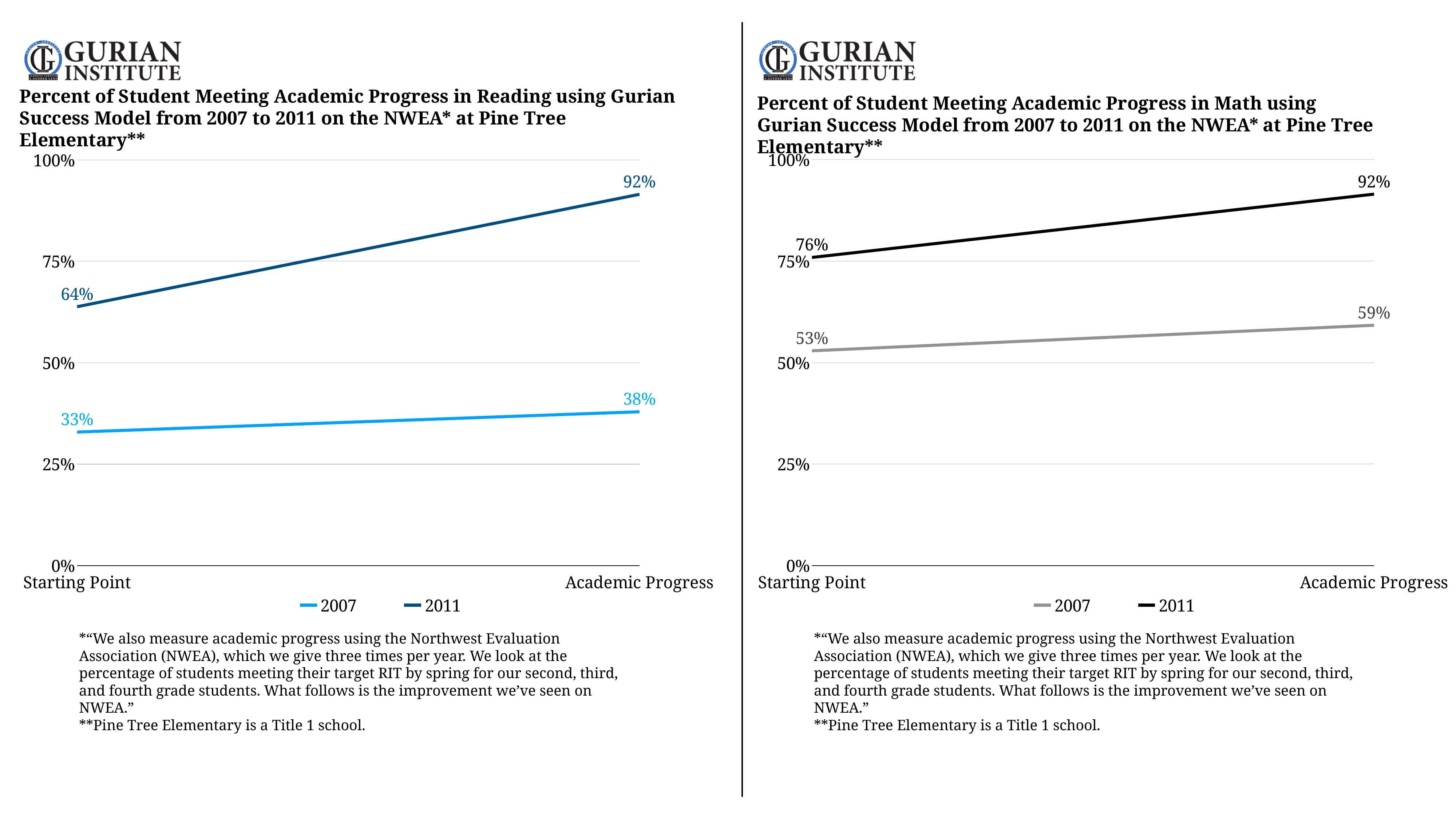
How many points are plotted along the x axis for each series in the Reading chart (left)? 2 What kind of chart is the Math chart (right)? line chart How many series does the legend of the Reading chart (left) list? 2 In the Math chart (right), what is the 2011 value at Starting Point? 76% In the Reading chart (left), what is the 2007 value at Starting Point? 33% In the Reading chart (left), what is the 2011 value at Academic Progress? 92% In the Math chart (right), what colour is the 2011 line? black In the Math chart (right), what is the 2007 value at Academic Progress? 59% In the Reading chart (left), what is the difference between the 2011 Academic Progress value and the 2011 Starting Point value? 28% In the Math chart (right), what is the difference between the 2007 Academic Progress value and the 2007 Starting Point value? 6% In the Reading chart (left), which series has the higher value at Academic Progress, 2007 or 2011? 2011 In the Math chart (right), does the 2007 series rise or fall from Starting Point to Academic Progress? rise